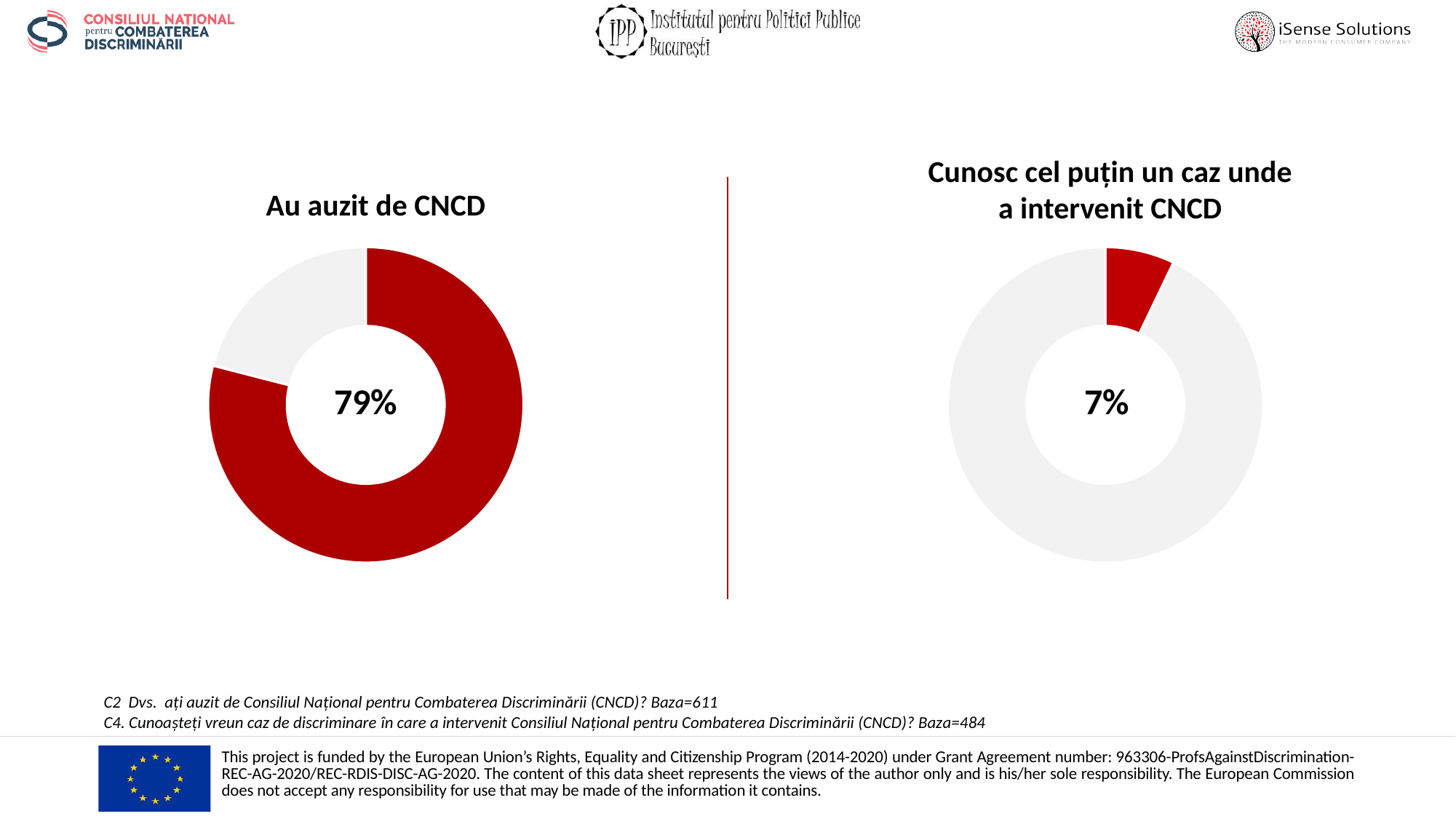
In the chart titled "Au auzit de CNCD", what share of the donut does the red segment represent? 79% How many donut charts are shown on the slide? 2 In the chart titled "Au auzit de CNCD", what percentage is shown in the centre of the donut? 79% Which chart shows the larger highlighted percentage, "Au auzit de CNCD" or "Cunosc cel puțin un caz unde a intervenit CNCD"? Au auzit de CNCD What kind of chart is used for "Au auzit de CNCD"? Donut (pie) chart What is the difference in percentage points between the value in "Au auzit de CNCD" (79%) and the value in "Cunosc cel puțin un caz unde a intervenit CNCD" (7%)? 72 percentage points In the chart titled "Cunosc cel puțin un caz unde a intervenit CNCD", what share of the donut does the red segment represent? 7% What is the title of the chart on the left side of the slide? Au auzit de CNCD In the chart titled "Cunosc cel puțin un caz unde a intervenit CNCD", what percentage is shown in the centre of the donut? 7% What kind of chart is used for "Cunosc cel puțin un caz unde a intervenit CNCD"? Donut (pie) chart What colour is used for the highlighted segment in both donut charts? Red